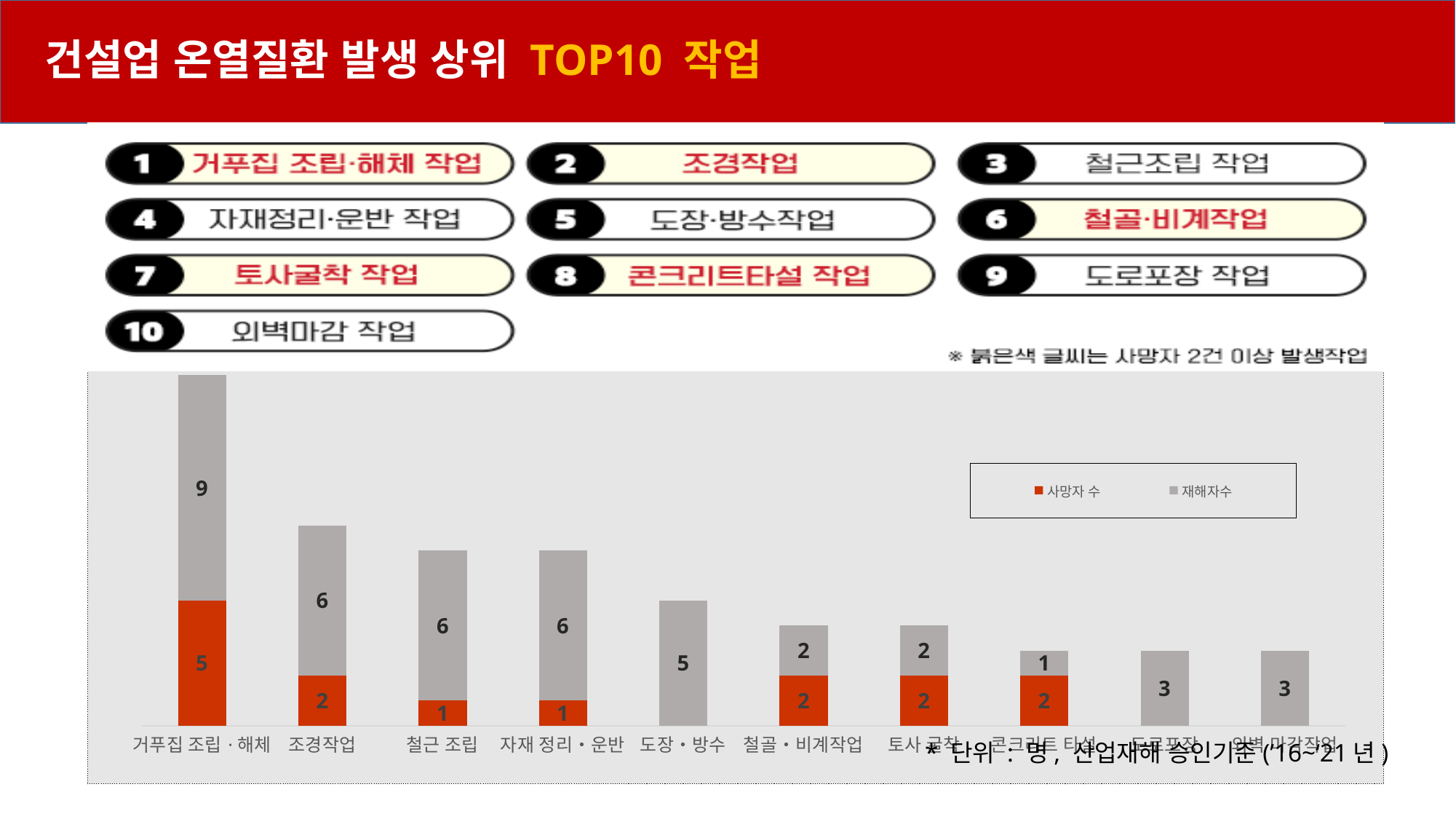
Which has the larger 사망자 수 value, 조경작업 or 철근 조립? 조경작업 What is the 재해자수 value for 도장·방수? 5 How many series does the chart legend list? 2 What are the two series named in the chart legend? 사망자 수, 재해자수 What is the total of the stacked bar for 거푸집 조립·해체? 14 What is the 사망자 수 value for 거푸집 조립·해체? 5 Which category has the highest 재해자수 value? 거푸집 조립·해체 What is the total of the stacked bar for 조경작업? 8 What kind of chart is shown at the bottom of the slide? Stacked bar chart What is the difference between the 재해자수 values for 거푸집 조립·해체 and 조경작업? 3 What is the 사망자 수 value for 철골·비계작업? 2 What is the 재해자수 value for 조경작업? 6